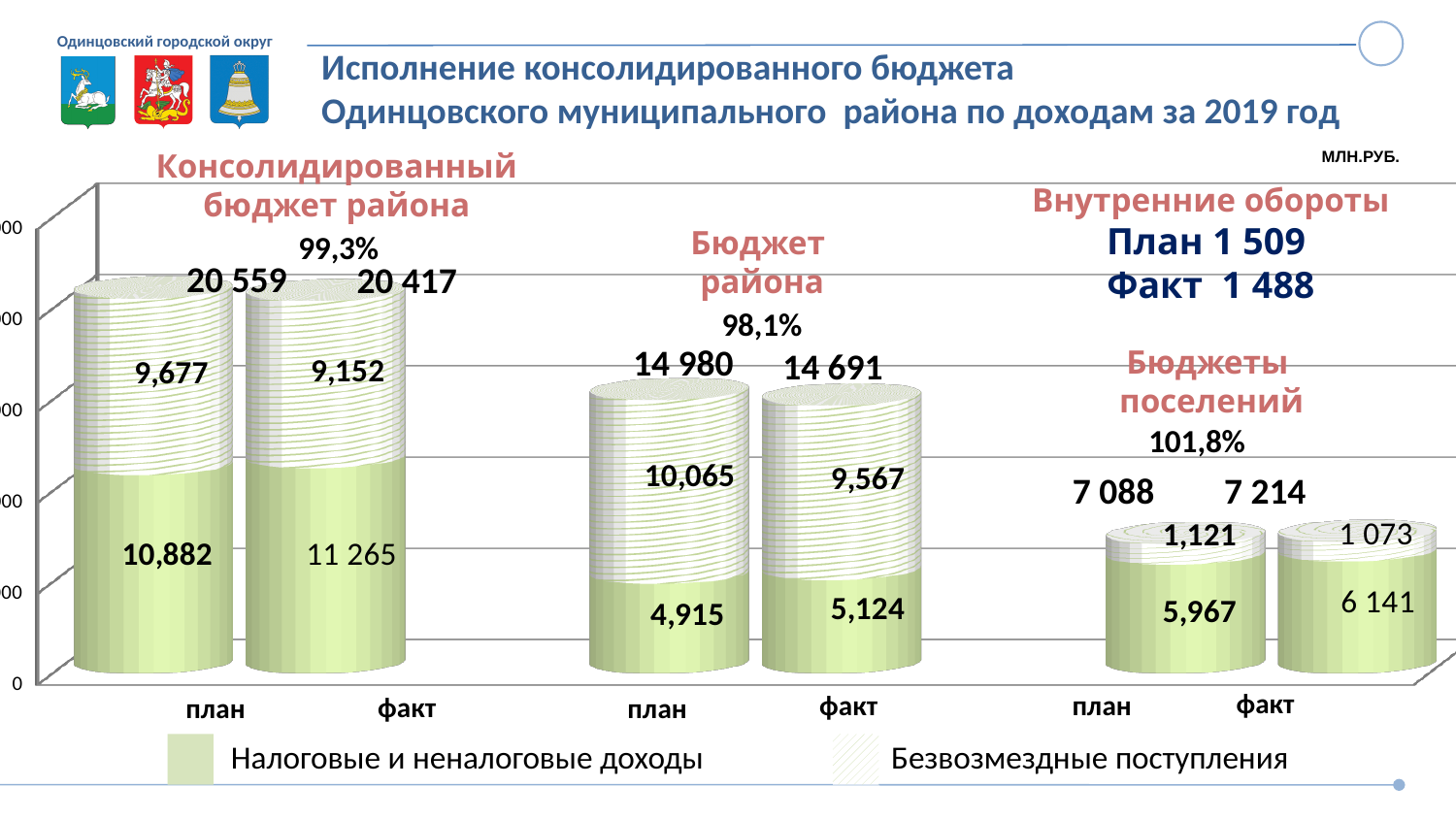
What is the difference between the план and факт totals for Консолидированный бюджет района? 142 What is the value of Безвозмездные поступления for the факт bar of Бюджет района? 9,567 What is the value of Безвозмездные поступления for the факт bar of Бюджеты поселений? 1 073 What is the total of the факт bar for Бюджеты поселений? 7 214 Which is larger for Бюджеты поселений: the план total or the факт total? факт Which bar has the highest total value? план, Консолидированный бюджет района What is the value of Налоговые и неналоговые доходы for the план bar of Консолидированный бюджет района? 10,882 Which bar has the lowest total value? план, Бюджеты поселений What percentage is shown above the Консолидированный бюджет района bars? 99,3% How many series does the legend list? 2 What is the total of the план bar for Бюджет района? 14 980 What kind of chart is shown on the slide? bar chart